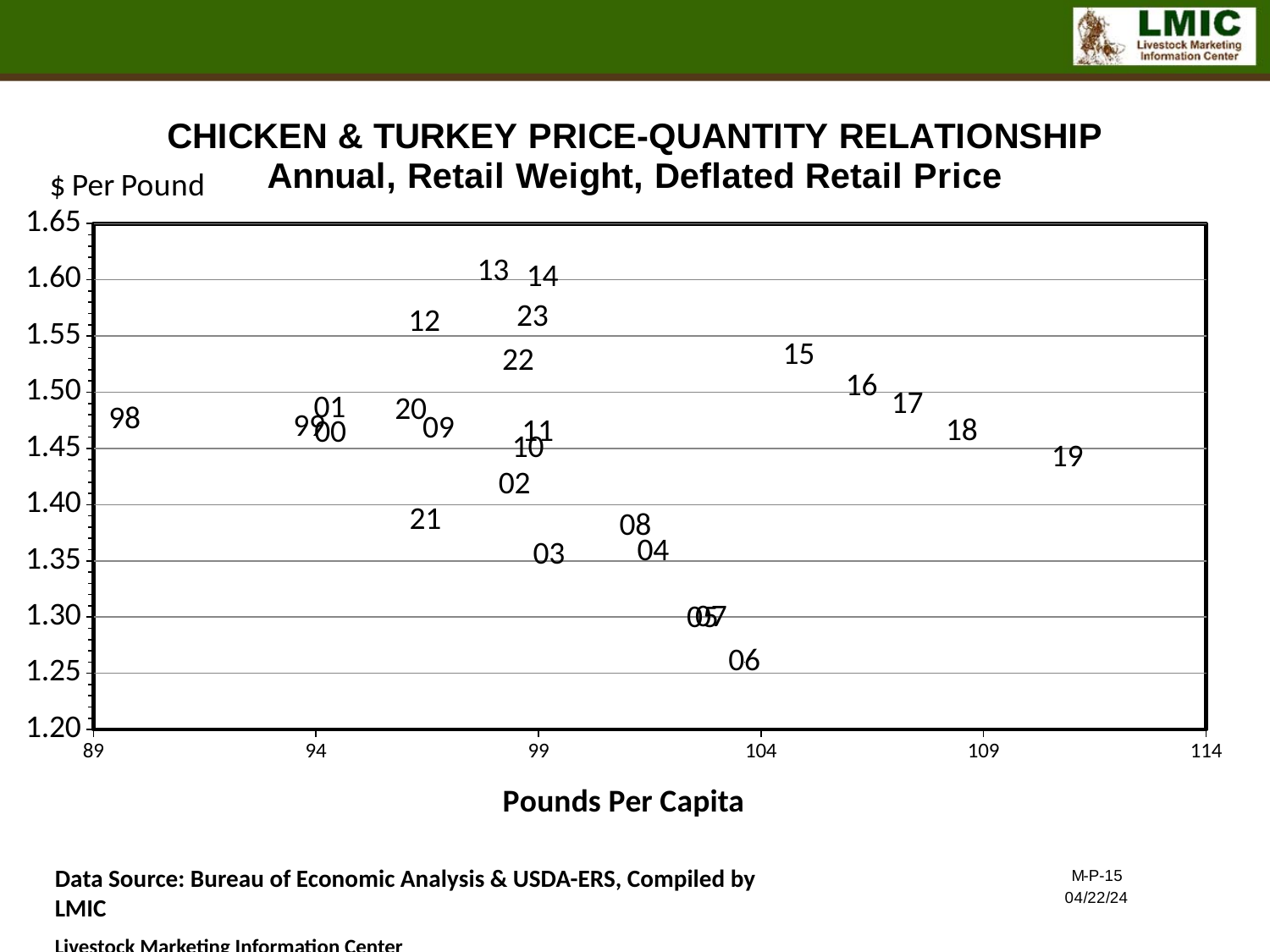
What kind of chart is shown on the slide? scatter chart Is the price for year 19 greater or less than 1.50? less Is the price for year 03 greater or less than 1.40? less Is the price for year 06 greater or less than 1.30? less Which year's point has the highest pounds per capita (farthest right)? 19 What unit label is shown for the y axis? $ Per Pound Which year's point has the lowest deflated retail price? 06 What is the title of the x axis? Pounds Per Capita Which has the higher price, year 16 or year 18? 16 Which has the higher price, year 13 or year 06? 13 Which year's point has the lowest pounds per capita (farthest left)? 98